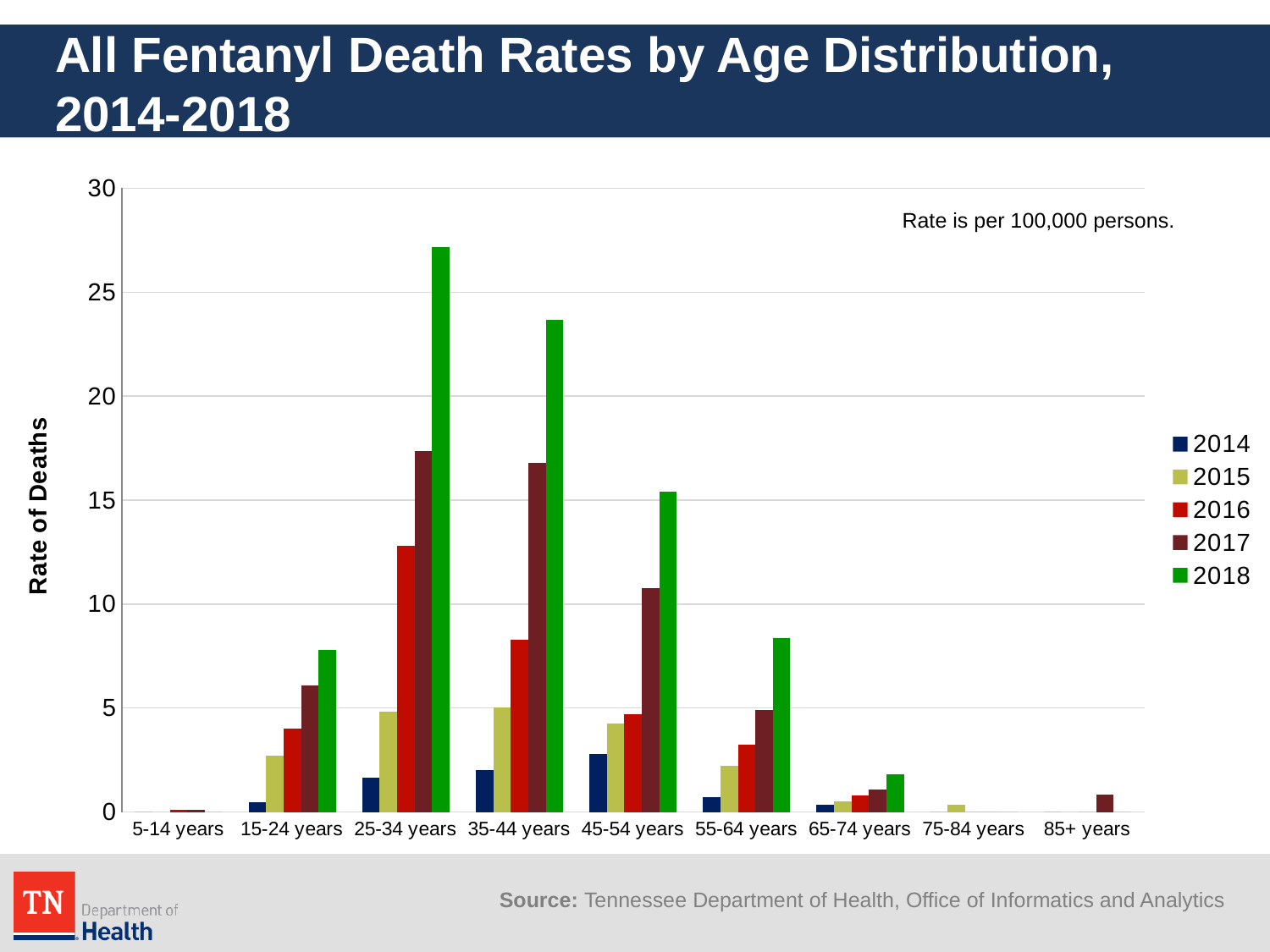
Which is larger, the 2018 value for 45-54 years or the 2018 value for 55-64 years? 45-54 years What does the note on the chart say the rate is per? 100,000 persons For the 25-34 years group, do the values rise or fall from 2014 to 2018? rise How many series does the legend list? 5 Is the 2018 value for 25-34 years greater or less than 25? greater Which is larger for the 35-44 years group, the 2016 value or the 2017 value? 2017 What kind of chart is shown on the slide? bar chart Which age group has the highest 2018 fentanyl death rate? 25-34 years Is the 2018 value for 35-44 years greater or less than 20? greater Is the 2017 value for 25-34 years greater or less than 15? greater How many age groups are shown on the x axis? 9